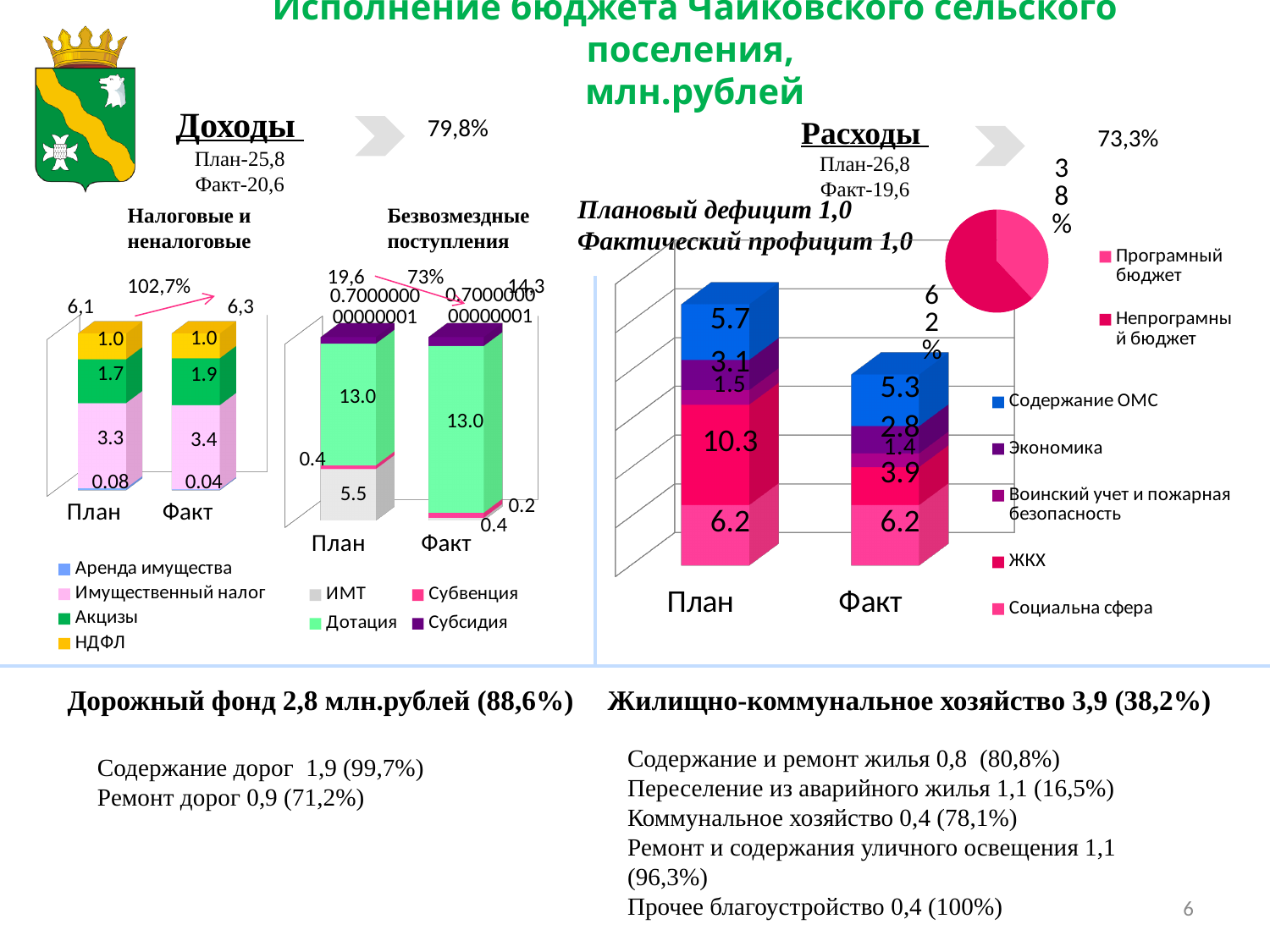
In the 'Расходы' chart, what is the difference between the ЖКХ values for План and Факт? 6.4 In the 'Безвозмездные поступления' chart, what is the value of Дотация for Факт? 13.0 In the 'Налоговые и неналоговые' chart, what is the value of Акцизы for Факт? 1.9 In the 'Расходы' chart, what is the value of Содержание ОМС for Факт? 5.3 In the 'Налоговые и неналоговые' chart, how many series does the legend list? 4 In the 'Безвозмездные поступления' chart, what is the value of ИМТ for План? 5.5 In the 'Расходы' chart, what is the value of ЖКХ for План? 10.3 In the 'Расходы' chart, which is larger: Экономика for План or Экономика for Факт? План In the 'Безвозмездные поступления' chart, which segment is the largest in the План bar? Дотация In the 'Налоговые и неналоговые' chart, what is the difference between the Акцизы values for Факт and План? 0.2 In the 'Налоговые и неналоговые' chart, what is the value of Имущественный налог for План? 3.3 What kind of chart is the 'Расходы' chart? Stacked bar chart